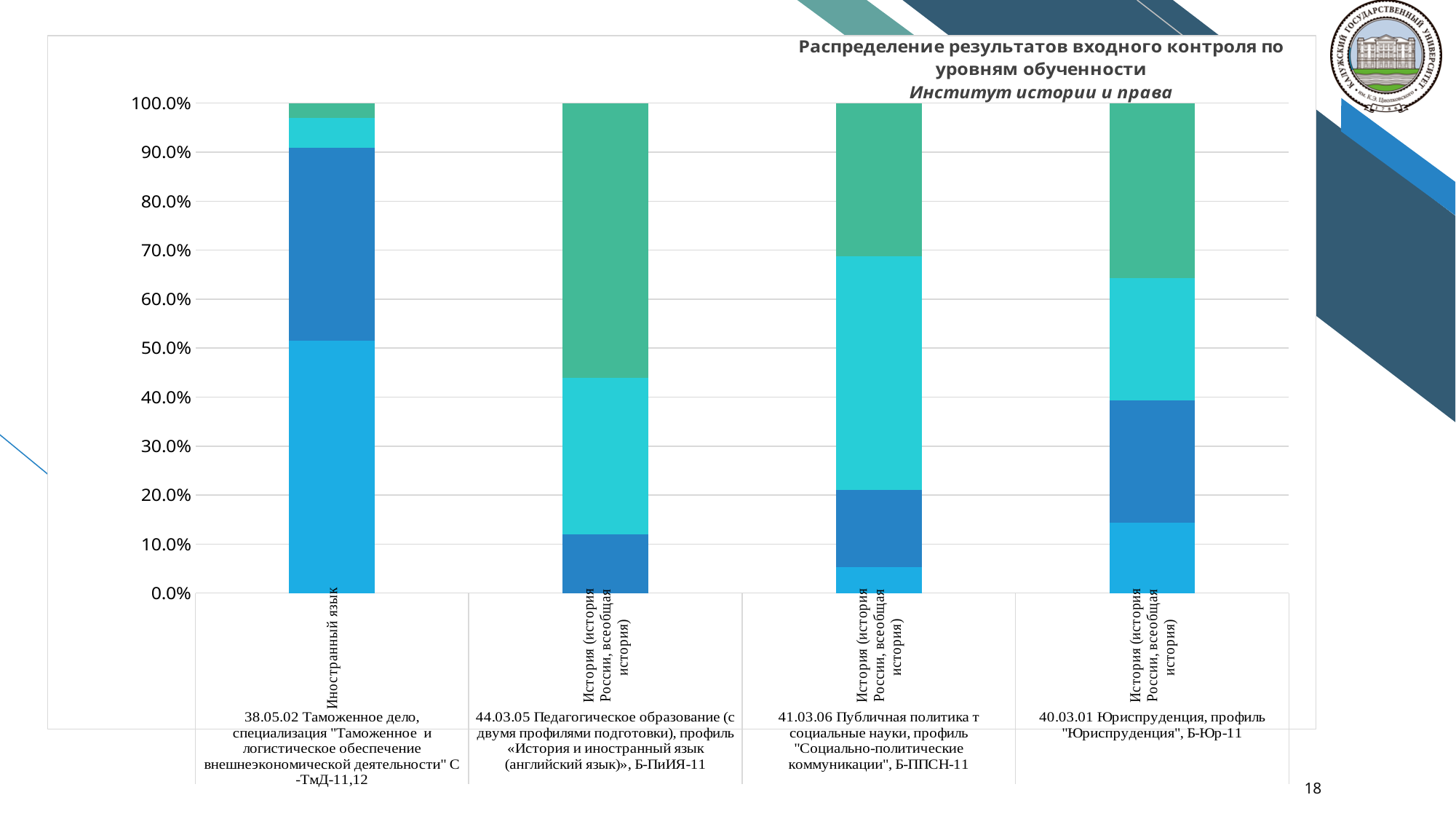
Is the top of the cyan segment for 41.03.06 Публичная политика, Б-ППСН-11 greater or less than 60%? greater Is the top of the light blue (bottom) segment for 38.05.02 Таможенное дело, С-ТмД-11,12 greater or less than 40%? greater Which bar has the largest dark blue segment: 38.05.02 Таможенное дело, С-ТмД-11,12 or 40.03.01 Юриспруденция, Б-Юр-11? 38.05.02 Таможенное дело, С-ТмД-11,12 How many programme categories (bars) are shown on the chart? 4 Which institute is named in the chart's subtitle? Институт истории и права Which bar has the largest cyan segment: 41.03.06 Публичная политика, Б-ППСН-11 or 38.05.02 Таможенное дело, С-ТмД-11,12? 41.03.06 Публичная политика, Б-ППСН-11 Is the top of the dark blue (bottom) segment for 44.03.05 Педагогическое образование, Б-ПиИЯ-11 greater or less than 20%? less Which bar has the largest green (top) segment: 44.03.05 Педагогическое образование, Б-ПиИЯ-11 or 41.03.06 Публичная политика, Б-ППСН-11? 44.03.05 Педагогическое образование, Б-ПиИЯ-11 What is the title of the chart? Распределение результатов входного контроля по уровням обученности What kind of chart is shown on the slide? Stacked bar chart